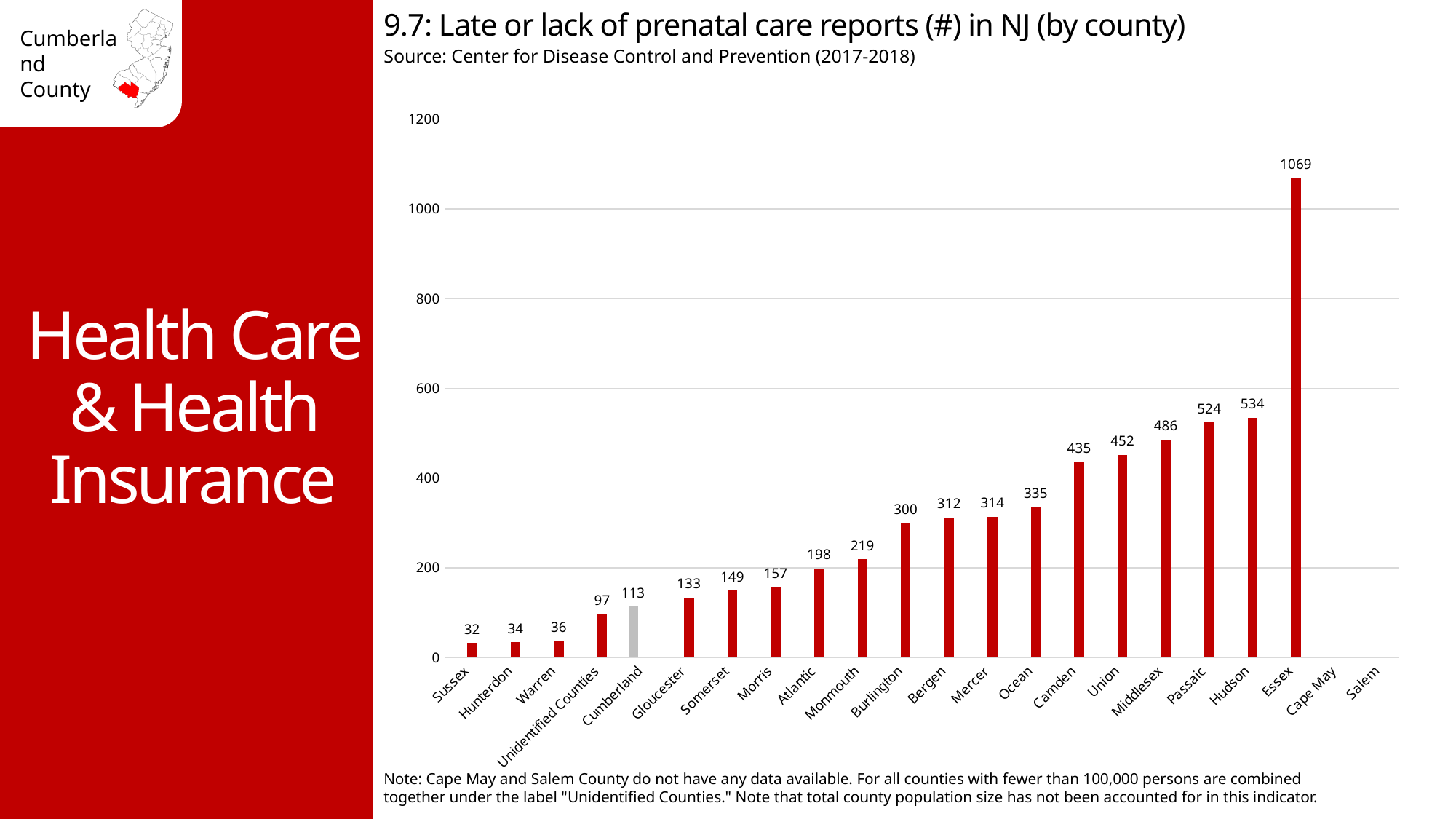
Which county has the highest number of late or lack of prenatal care reports? Essex What is the combined total of the values for Sussex, Hunterdon and Warren? 102 Is the value for Ocean County greater or less than 400? less What is the number of late or lack of prenatal care reports for Cumberland County? 113 Which county has the lowest number of reports among those with data? Sussex Which county has a larger value, Camden or Union? Union What is the value shown for Essex County? 1069 What kind of chart is shown on the slide? bar chart What is the difference between the values for Hudson and Passaic? 10 Which county's bar is coloured grey instead of red? Cumberland How many county labels are shown along the x axis? 22 Do the values generally rise or fall from left to right along the x axis? rise